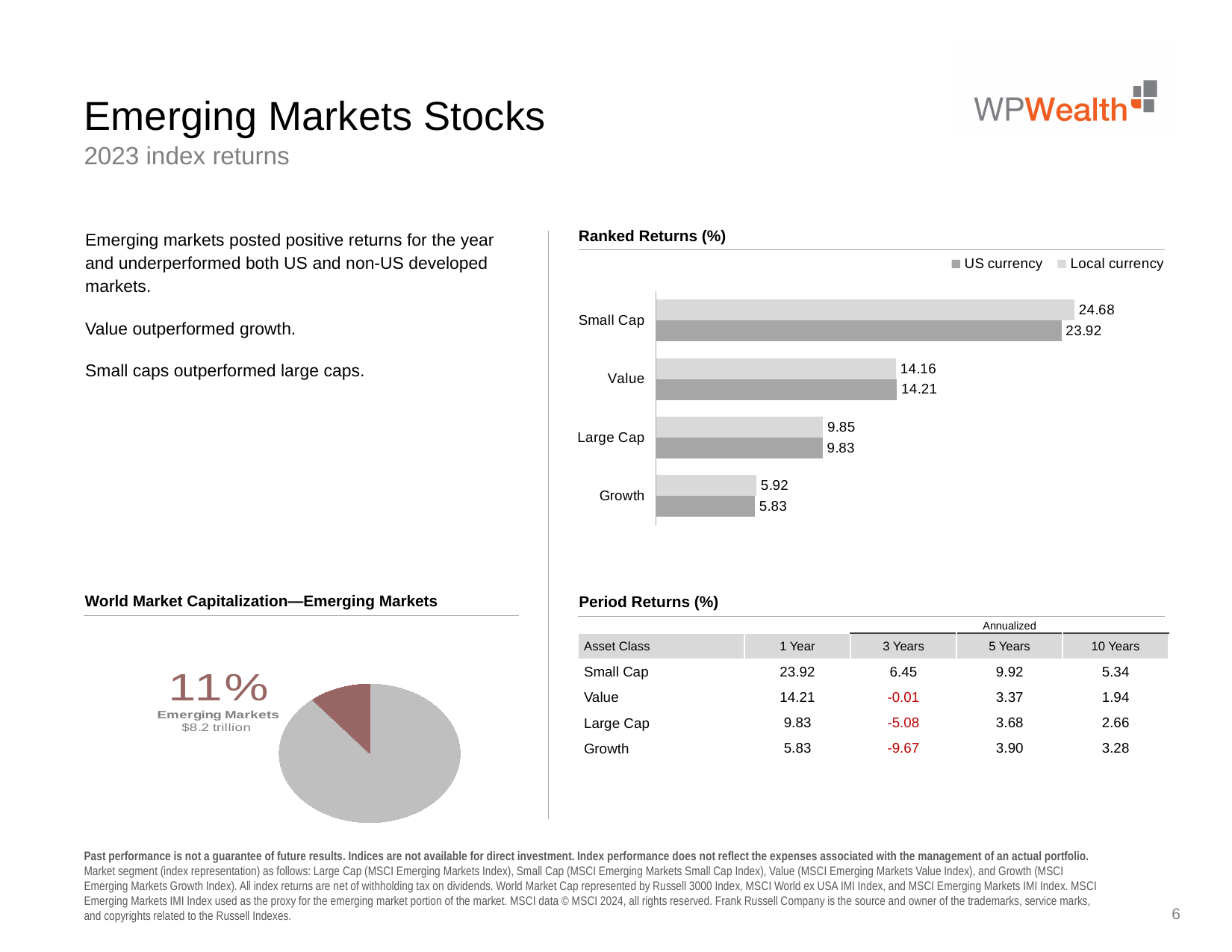
In the Ranked Returns (%) chart, which is larger: the US currency return for Value or the US currency return for Large Cap? Value What kind of chart is the Ranked Returns (%) chart? Bar chart How many categories are shown in the Ranked Returns (%) chart? 4 How many series does the legend of the Ranked Returns (%) chart list? 2 In the Ranked Returns (%) chart, which category has the lowest Local currency return? Growth In the Ranked Returns (%) chart, what is the Local currency return for Value? 14.16 In the Ranked Returns (%) chart, what is the US currency return for Growth? 5.83 In the Ranked Returns (%) chart, what is the US currency return for Small Cap? 23.92 In the Ranked Returns (%) chart, which category has the highest US currency return? Small Cap In the Ranked Returns (%) chart, what is the Local currency return for Large Cap? 9.85 In the World Market Capitalization—Emerging Markets pie chart, what share of world market capitalization do Emerging Markets represent? 11% In the Ranked Returns (%) chart, what is the difference between the Local currency and US currency returns for Small Cap? 0.76